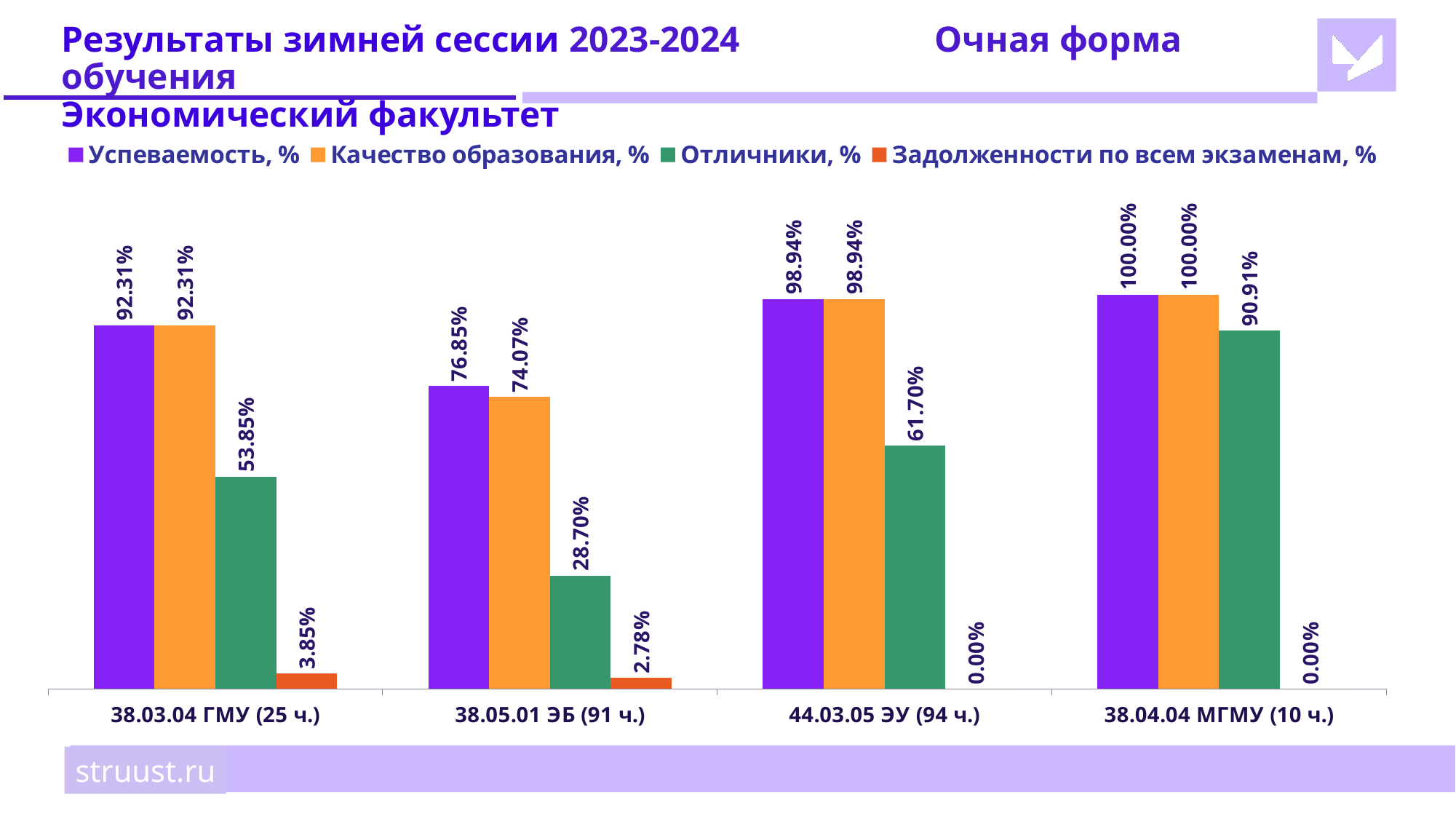
How many series does the legend list? 4 Which is larger: Отличники, % for 38.03.04 ГМУ (25 ч.) or Отличники, % for 38.05.01 ЭБ (91 ч.)? 38.03.04 ГМУ (25 ч.) Which colour represents Задолженности по всем экзаменам, % in the legend? Red-orange What is the value of Задолженности по всем экзаменам, % for 38.03.04 ГМУ (25 ч.)? 3.85% What is the value of Качество образования, % for 38.04.04 МГМУ (10 ч.)? 100.00% What is the value of Успеваемость, % for 38.05.01 ЭБ (91 ч.)? 76.85% Which category has the lowest value of Успеваемость, %? 38.05.01 ЭБ (91 ч.) How many categories are shown on the x axis? 4 What kind of chart is shown on the slide? Bar chart What is the difference between Успеваемость, % and Качество образования, % for 38.05.01 ЭБ (91 ч.)? 2.78% Which category has the highest value of Отличники, %? 38.04.04 МГМУ (10 ч.) What is the value of Отличники, % for 44.03.05 ЭУ (94 ч.)? 61.70%